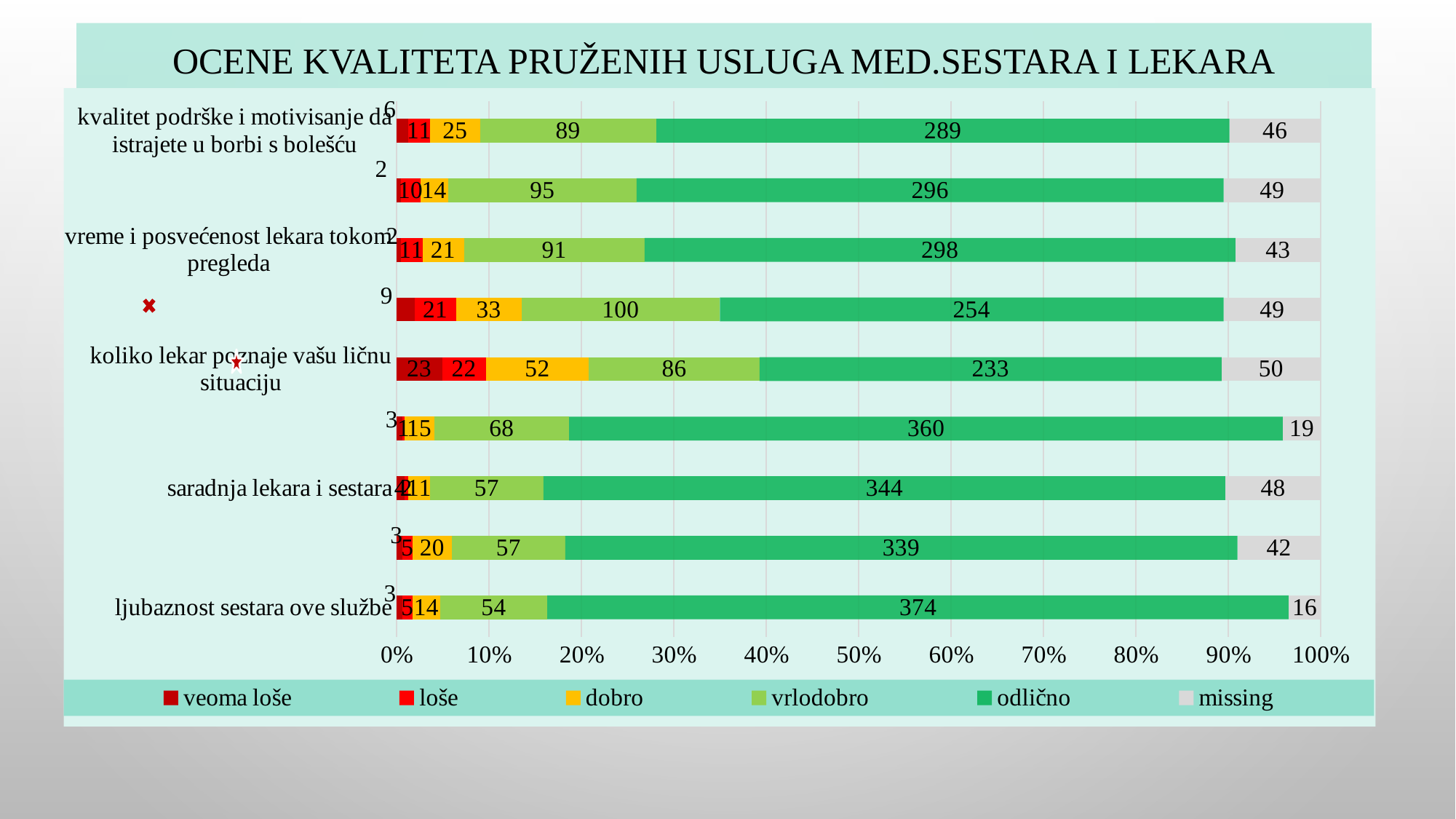
What kind of chart is shown on the slide? bar chart What is the 'dobro' value for 'vreme i posvećenost lekara tokom pregleda'? 21 What is the difference between the 'missing' values for 'koliko lekar poznaje vašu ličnu situaciju' and 'ljubaznost sestara ove službe'? 34 How many series does the legend list? 6 Which has the larger 'odlično' value: 'kvalitet podrške i motivisanje da istrajete u borbi s bolešću' or 'vreme i posvećenost lekara tokom pregleda'? vreme i posvećenost lekara tokom pregleda What is the 'vrlodobro' value for 'koliko lekar poznaje vašu ličnu situaciju'? 86 What is the 'missing' value for 'kvalitet podrške i motivisanje da istrajete u borbi s bolešću'? 46 What is the 'odlično' value for 'ljubaznost sestara ove službe'? 374 What is the 'odlično' value for 'koliko lekar poznaje vašu ličnu situaciju'? 233 Which category has the highest 'odlično' value? ljubaznost sestara ove službe What is the title of the chart? OCENE KVALITETA PRUŽENIH USLUGA MED.SESTARA I LEKARA What is the 'veoma loše' value for 'koliko lekar poznaje vašu ličnu situaciju'? 23